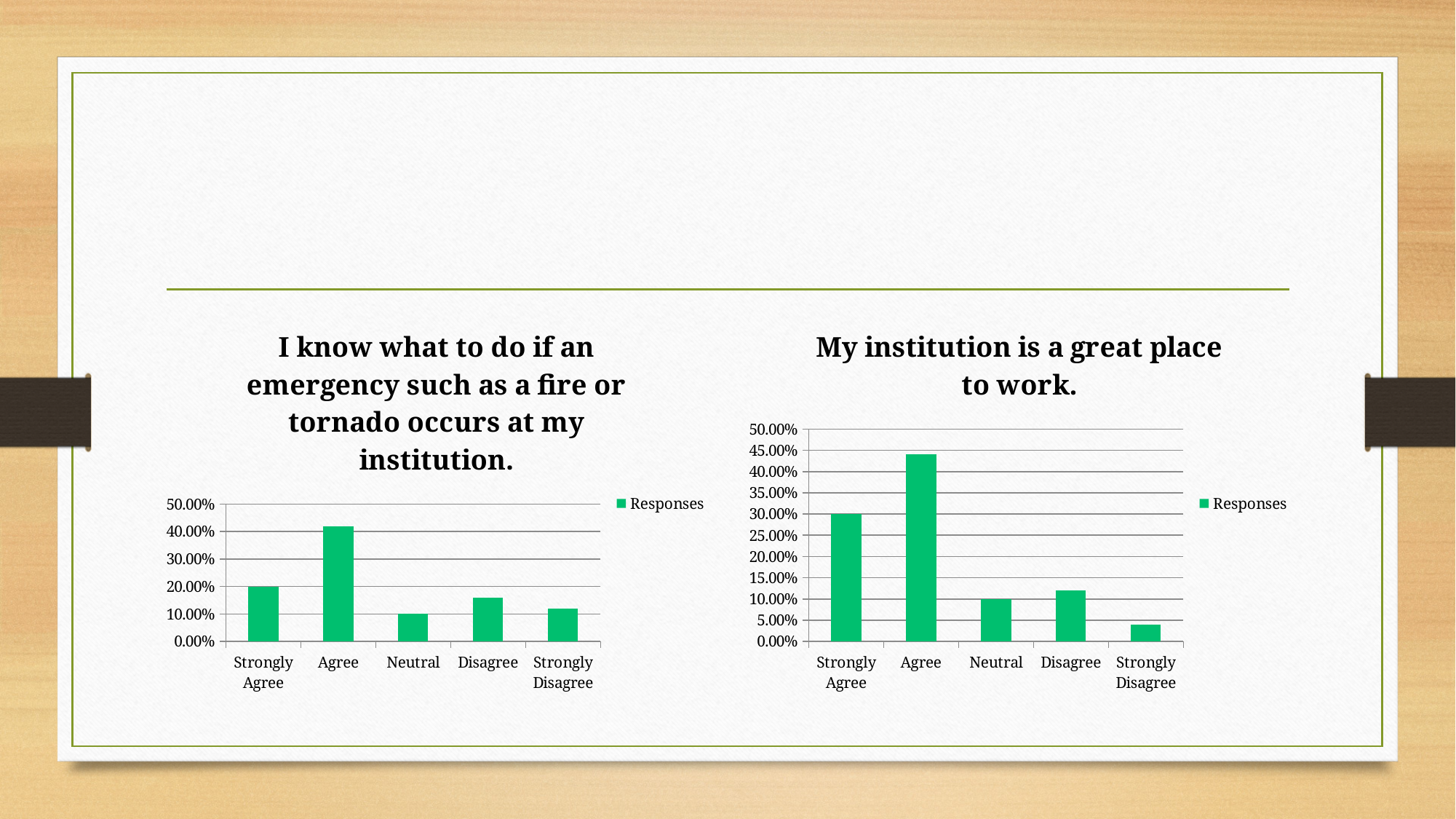
On the left chart ("I know what to do if an emergency..."), which category has the lowest value? Neutral What kind of chart is the left chart ("I know what to do if an emergency...")? bar chart On the right chart ("My institution is a great place to work."), which category has the lowest value? Strongly Disagree On the left chart ("I know what to do if an emergency..."), which is larger, Disagree or Strongly Disagree? Disagree On the right chart ("My institution is a great place to work."), which is larger, Strongly Agree or Disagree? Strongly Agree On the left chart ("I know what to do if an emergency..."), is the value for Agree greater or less than 40.00%? greater On the left chart ("I know what to do if an emergency..."), which category has the highest value? Agree How many categories are shown on the x axis of the right chart ("My institution is a great place to work.")? 5 On the right chart ("My institution is a great place to work."), which category has the highest value? Agree On the right chart ("My institution is a great place to work."), is the value for Strongly Agree greater or less than 25.00%? greater On the left chart ("I know what to do if an emergency..."), is the value for Disagree greater or less than 20.00%? less